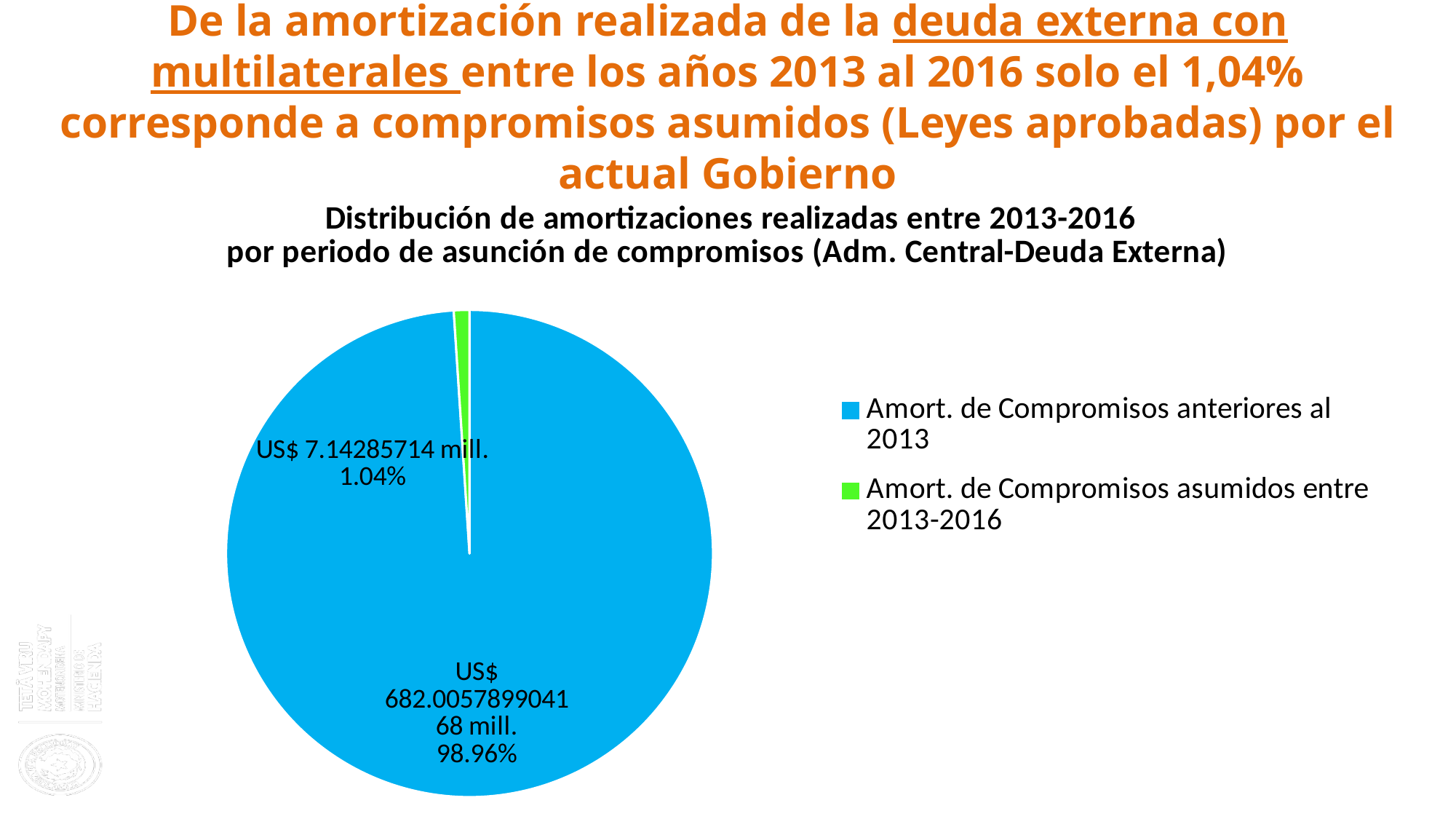
Which slice is the smallest? Amort. de Compromisos asumidos entre 2013-2016 How many entries does the legend list? 2 Which is larger: the share for 'Amort. de Compromisos anteriores al 2013' or for 'Amort. de Compromisos asumidos entre 2013-2016'? Amort. de Compromisos anteriores al 2013 What is the difference in percentage points between the two slices' shares? 97.92 How many slices does the pie chart have? 2 What kind of chart is shown on the slide? pie chart What value is labelled on the slice 'Amort. de Compromisos asumidos entre 2013-2016'? US$ 7.14285714 mill. What percentage share does the slice 'Amort. de Compromisos anteriores al 2013' have? 98.96% What value is labelled on the slice 'Amort. de Compromisos anteriores al 2013'? US$ 682.005789904168 mill. What percentage share does the slice 'Amort. de Compromisos asumidos entre 2013-2016' have? 1.04% What colour is the slice for 'Amort. de Compromisos asumidos entre 2013-2016'? green Which slice is the largest? Amort. de Compromisos anteriores al 2013